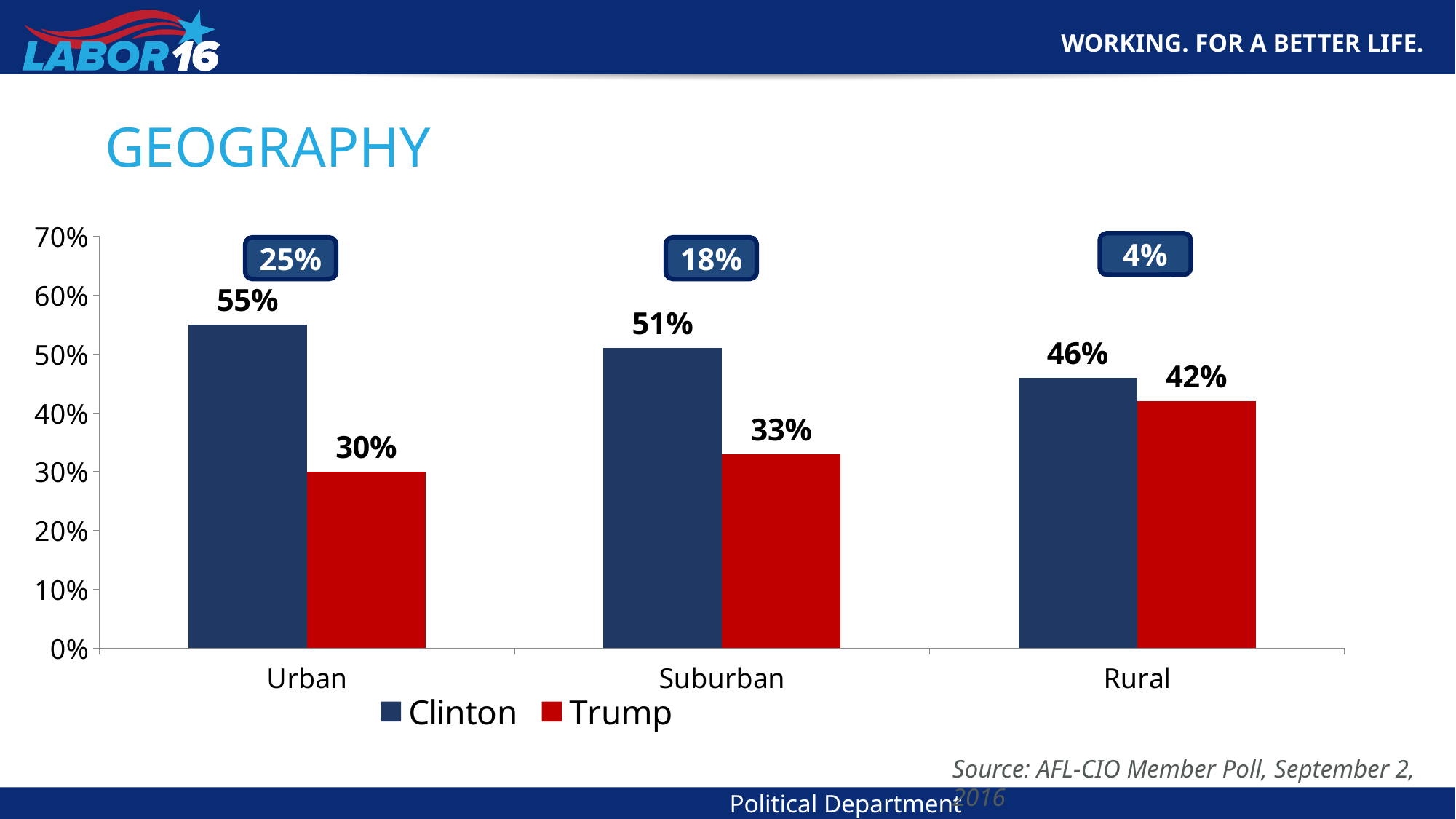
Which is larger in the Rural category, Clinton's value or Trump's value? Clinton What is the difference between Clinton's and Trump's values in the Suburban category? 18% What is the value for Clinton in the Urban category? 55% What is the value for Trump in the Suburban category? 33% Is the value for Trump in the Urban category greater or less than 40%? less How many series does the legend list? 2 How many categories are shown on the x axis? 3 In which category is Trump's value lowest? Urban What is the value for Trump in the Rural category? 42% In which category is Clinton's value highest? Urban What kind of chart is shown on the slide? bar chart Do Trump's values rise or fall from Urban to Rural? rise